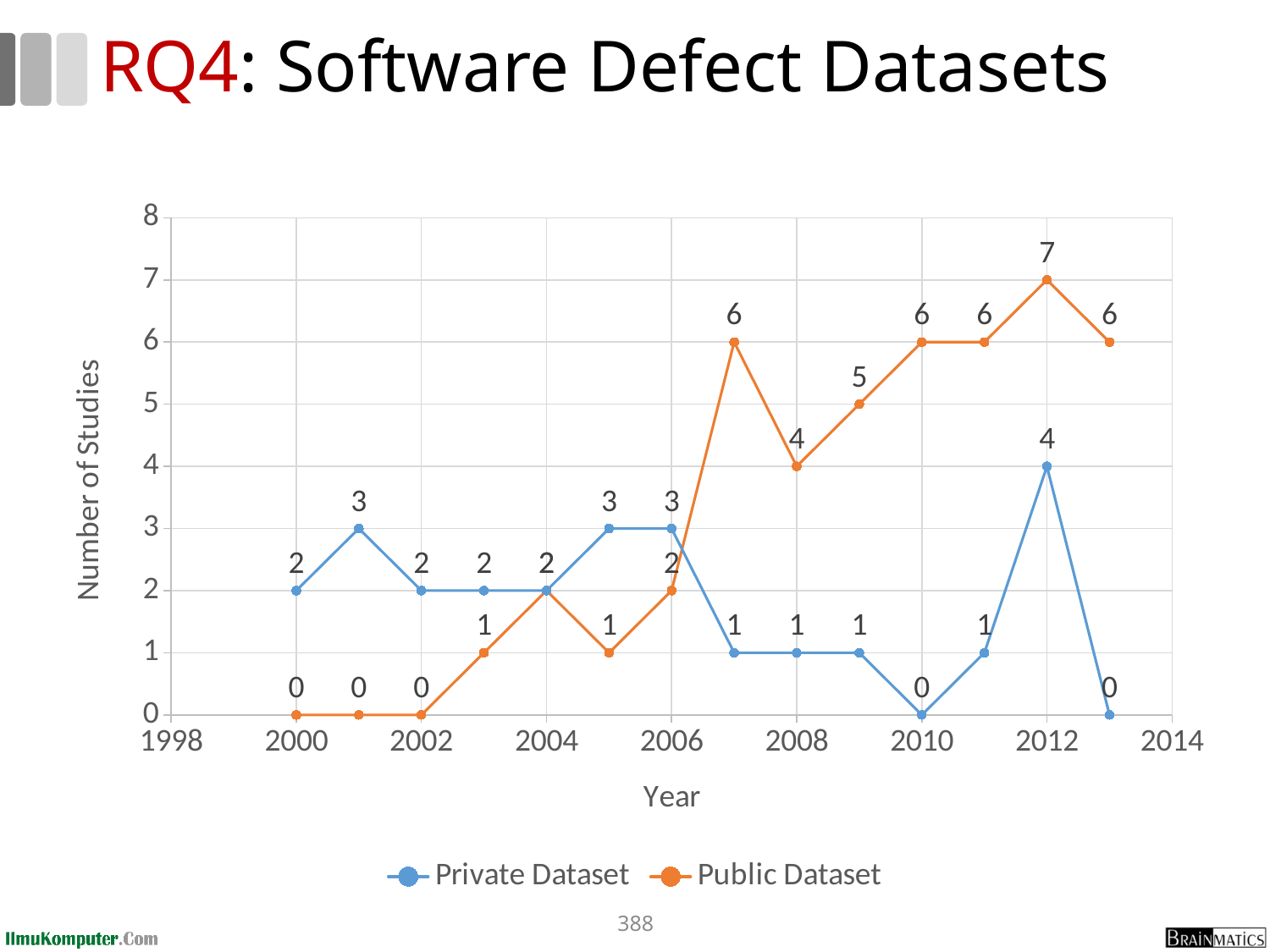
What is the value for Public Dataset in 2008? 4 What kind of chart is shown on the slide? Line chart In which year does the Public Dataset series reach its highest value? 2012 Which series has the larger value in 2010? Public Dataset How many series does the legend list? 2 What is the value for Public Dataset in 2012? 7 Which series has the larger value in 2004? They are equal (both 2) What is the label of the y axis? Number of Studies How many years are plotted for each series? 14 What is the value for Private Dataset in 2012? 4 What is the difference between the Public Dataset and Private Dataset values in 2007? 5 In which year does the Private Dataset series reach its highest value? 2012